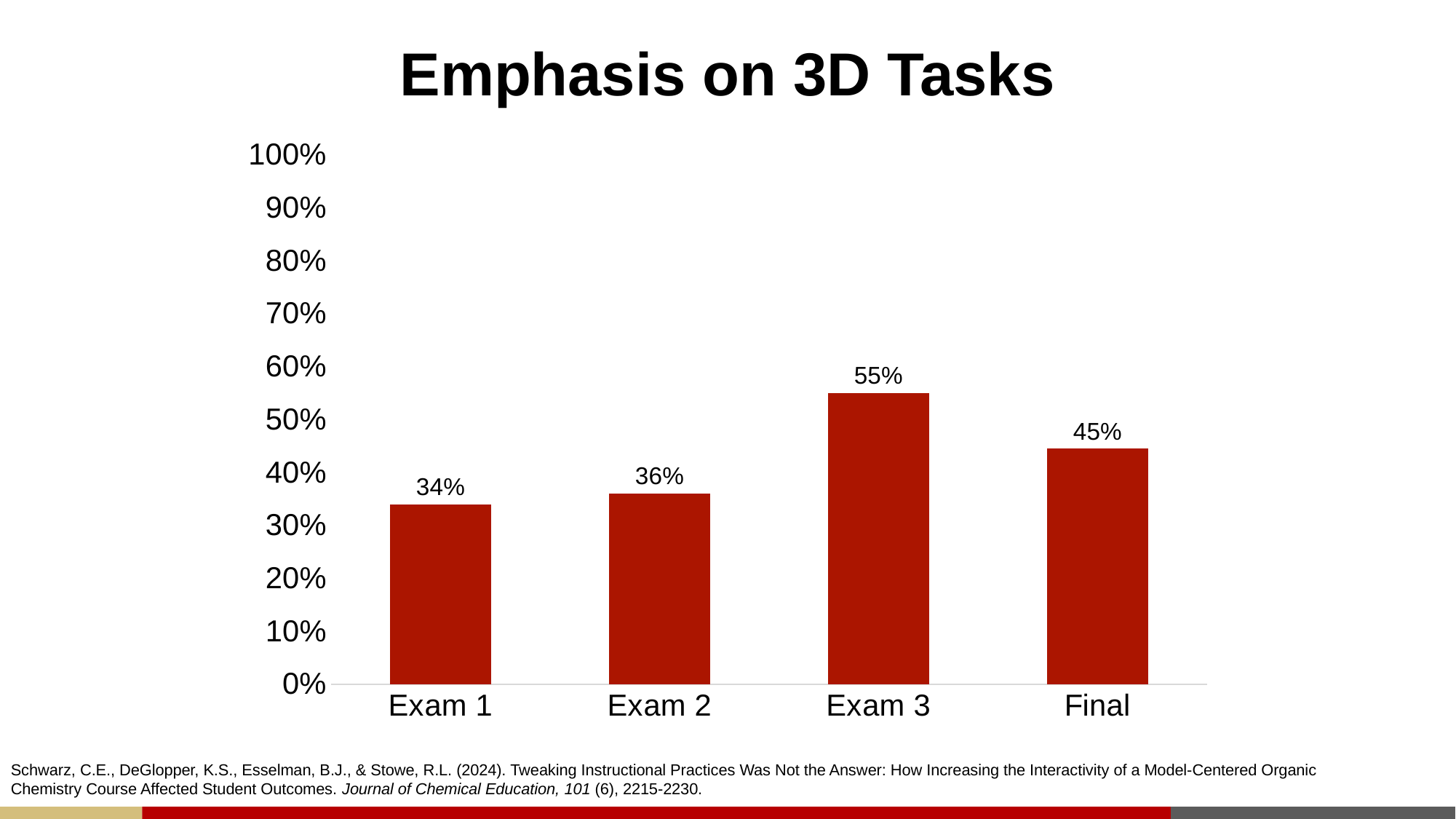
What is the value for Exam 3? 55% Which is larger, the value for Exam 3 or the value for Final? Exam 3 How many categories are shown on the x axis? 4 Which category has the highest value? Exam 3 Which category has the lowest value? Exam 1 What is the difference between the values for Exam 3 and Exam 2? 19% Is the value for Exam 2 greater or less than 40%? less What kind of chart is shown on the slide? bar chart What is the value for Final? 45% What is the difference between the values for Final and Exam 1? 11% What is the value for Exam 1? 34% What is the title of the chart? Emphasis on 3D Tasks